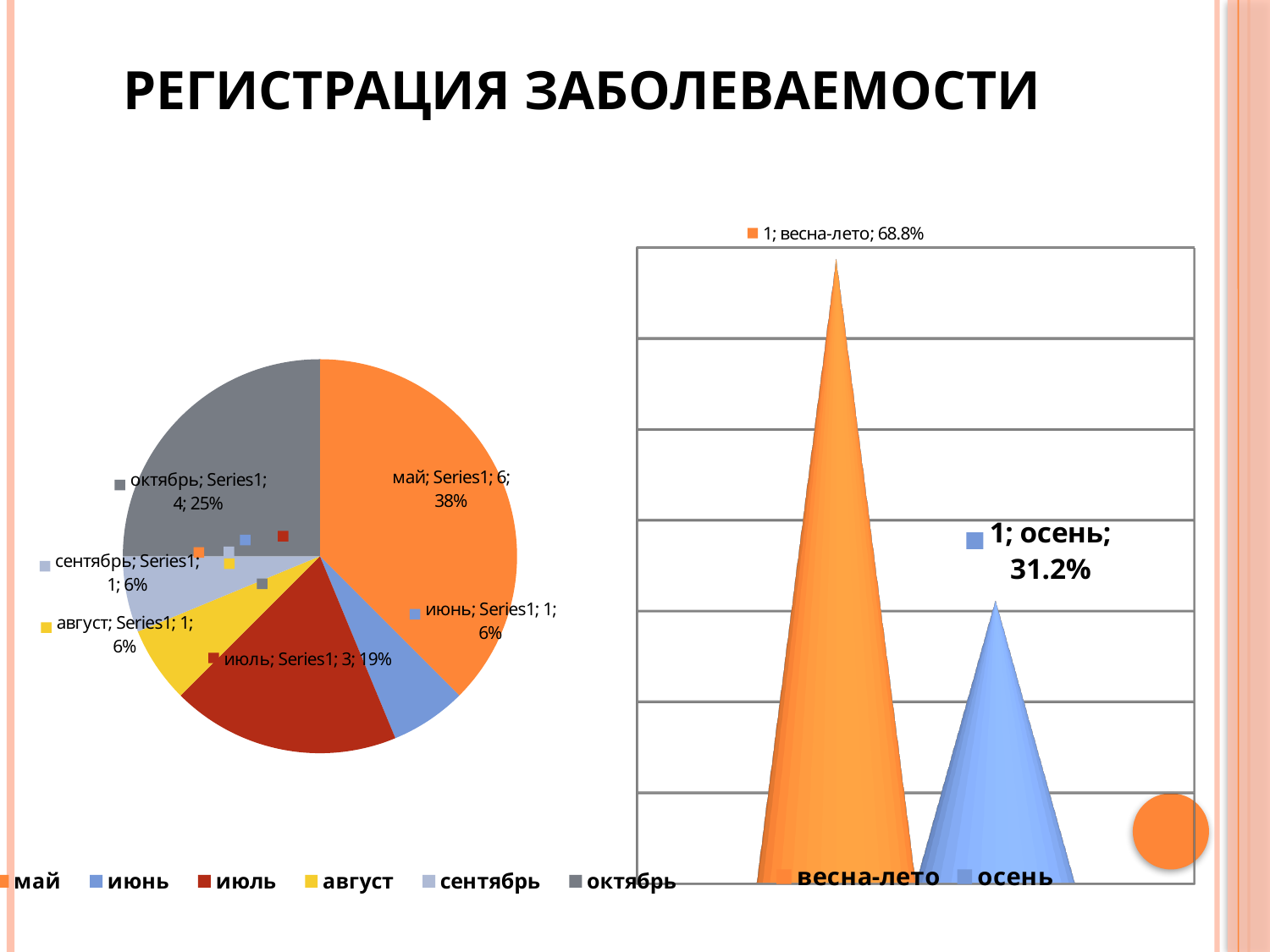
In the chart on the right, what is the difference between the values for весна-лето and осень? 37.6% In the pie chart on the left, which is larger, the value for июль or the value for октябрь? октябрь In the pie chart on the left, what percentage share does октябрь have? 25% In the pie chart on the left, what percentage share does июль have? 19% What kind of chart is the chart on the left? pie chart In the chart on the right, what value is shown for весна-лето? 68.8% In the chart on the right, what value is shown for осень? 31.2% In the pie chart on the left, which month has the largest slice? май In the pie chart on the left, what is the difference between the values for май and октябрь? 2 In the chart on the right, which category has the higher value? весна-лето In the pie chart on the left, what value is shown for май? 6 In the pie chart on the left, how many months (categories) are shown? 6